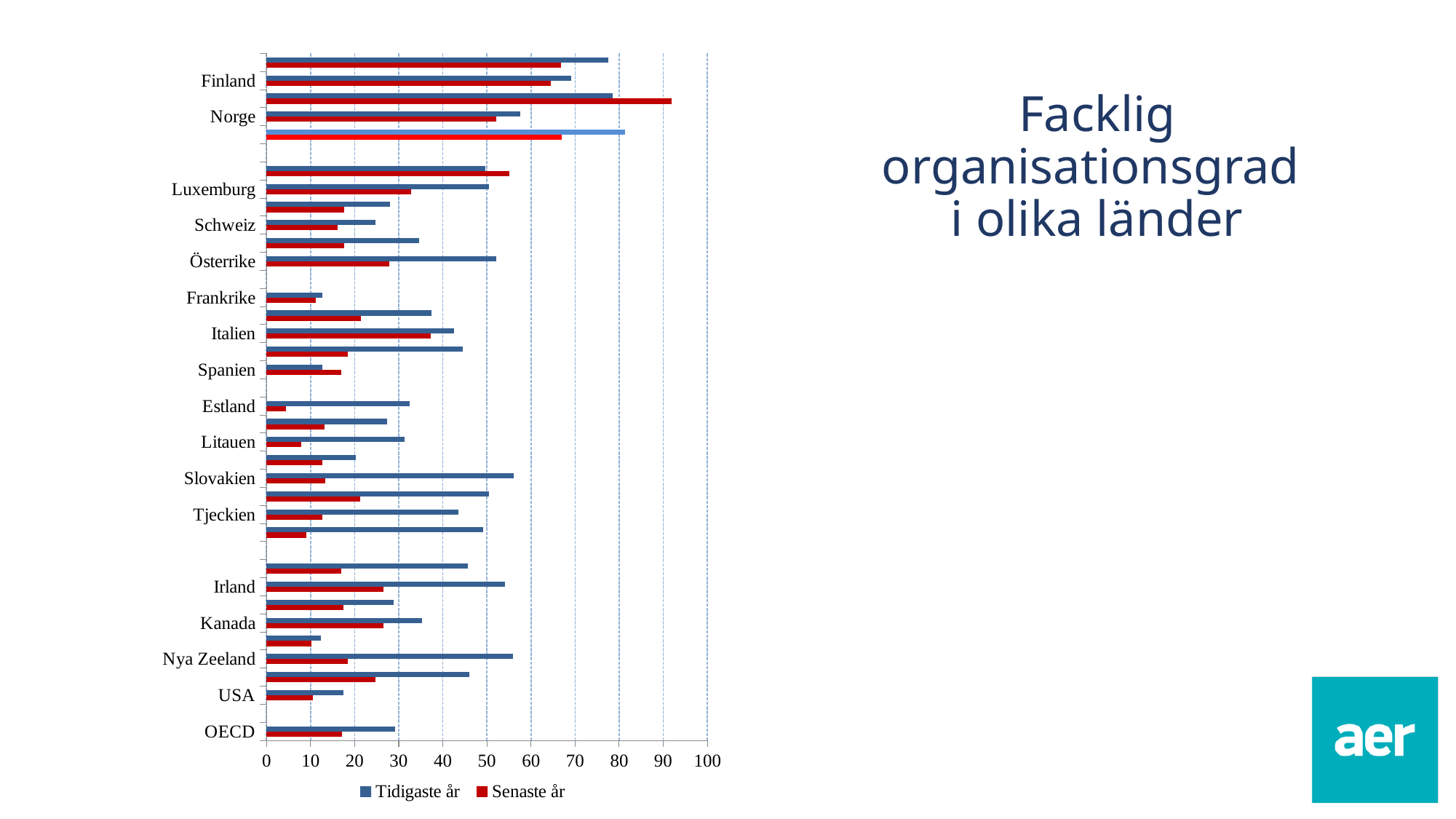
For Irland, which series has the larger value, Tidigaste år or Senaste år? Tidigaste år Is the Senaste år value for Luxemburg greater or less than 40? less What kind of chart is shown on the slide? bar chart Is the Tidigaste år value for OECD greater or less than 20? greater Is the Tidigaste år value for Finland greater or less than 60? greater For Slovakien, which series has the larger value, Tidigaste år or Senaste år? Tidigaste år What are the two series named in the legend? Tidigaste år and Senaste år What is the title shown on the slide? Facklig organisationsgrad i olika länder How many series does the legend list? 2